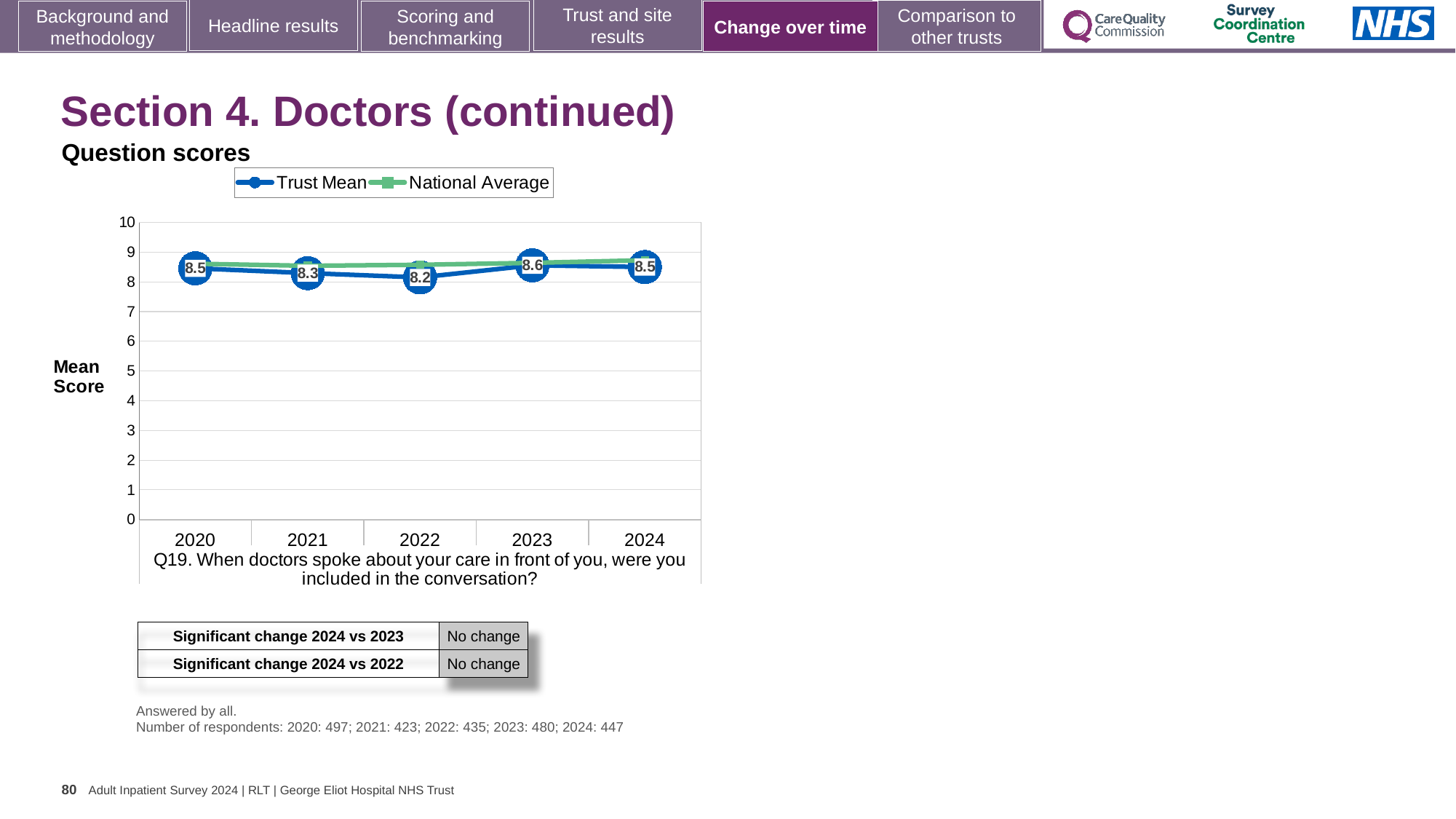
Is the Trust Mean score for 2024 greater or less than 8? greater Which survey question does the chart show scores for? Q19. When doctors spoke about your care in front of you, were you included in the conversation? What kind of chart is shown on the slide? Line chart How many years are shown on the x axis of the chart? 5 In which year is the Trust Mean score lowest? 2022 How many series does the chart legend list? 2 What is the Trust Mean score for 2023? 8.6 What is the Trust Mean score for 2022? 8.2 Which year has a higher Trust Mean score, 2021 or 2023? 2023 In which year is the Trust Mean score highest? 2023 What is the difference between the Trust Mean scores for 2023 and 2022? 0.4 What is the Trust Mean score for 2020? 8.5